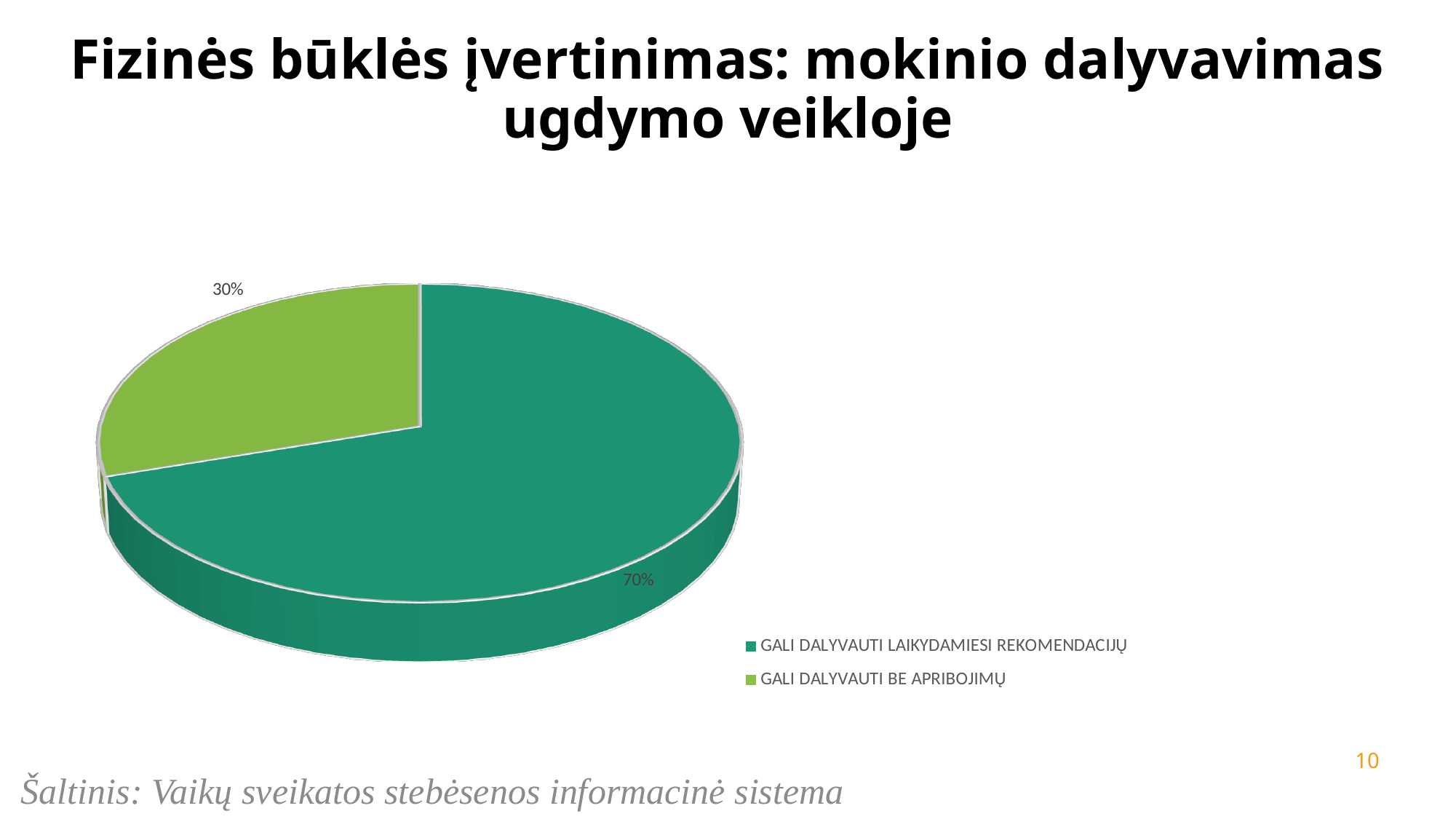
What share of the pie is labelled GALI DALYVAUTI BE APRIBOJIMŲ? 30% What kind of chart is shown on the slide? Pie chart How many slices does the pie chart have? 2 What is the title of the slide containing the pie chart? Fizinės būklės įvertinimas: mokinio dalyvavimas ugdymo veikloje Which category has the largest slice of the pie? GALI DALYVAUTI LAIKYDAMIESI REKOMENDACIJŲ Which category has the smallest slice of the pie? GALI DALYVAUTI BE APRIBOJIMŲ Which is larger: the GALI DALYVAUTI BE APRIBOJIMŲ slice or the GALI DALYVAUTI LAIKYDAMIESI REKOMENDACIJŲ slice? GALI DALYVAUTI LAIKYDAMIESI REKOMENDACIJŲ What share of the pie is labelled GALI DALYVAUTI LAIKYDAMIESI REKOMENDACIJŲ? 70% How many entries does the legend list? 2 What is the difference in percentage points between the GALI DALYVAUTI LAIKYDAMIESI REKOMENDACIJŲ slice and the GALI DALYVAUTI BE APRIBOJIMŲ slice? 40 percentage points What colour is the GALI DALYVAUTI BE APRIBOJIMŲ slice? Light green